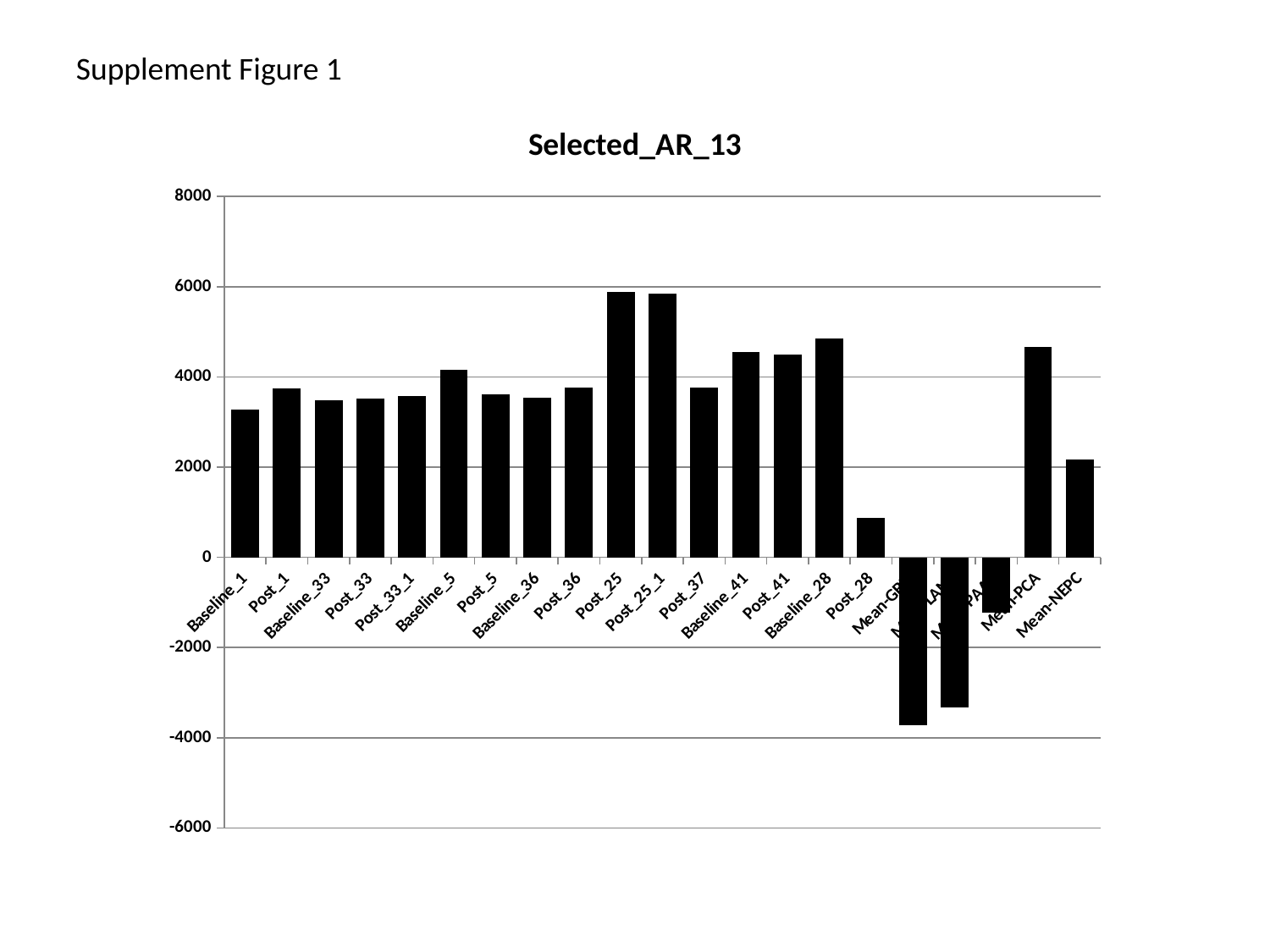
Which is larger, the value for Mean-PCA or the value for Mean-NEPC? Mean-PCA Which is larger, the value for Baseline_28 or the value for Post_28? Baseline_28 What kind of chart is shown on the slide? bar chart What is the highest value shown on the vertical axis? 8000 How many bars extend below zero in the chart? 3 Is the value for Post_25 greater or less than 4000? greater What is the title of the chart? Selected_AR_13 Is the value for Mean-PCA greater or less than 4000? greater Is the value for Baseline_1 greater or less than 4000? less How many bars are plotted in the chart? 21